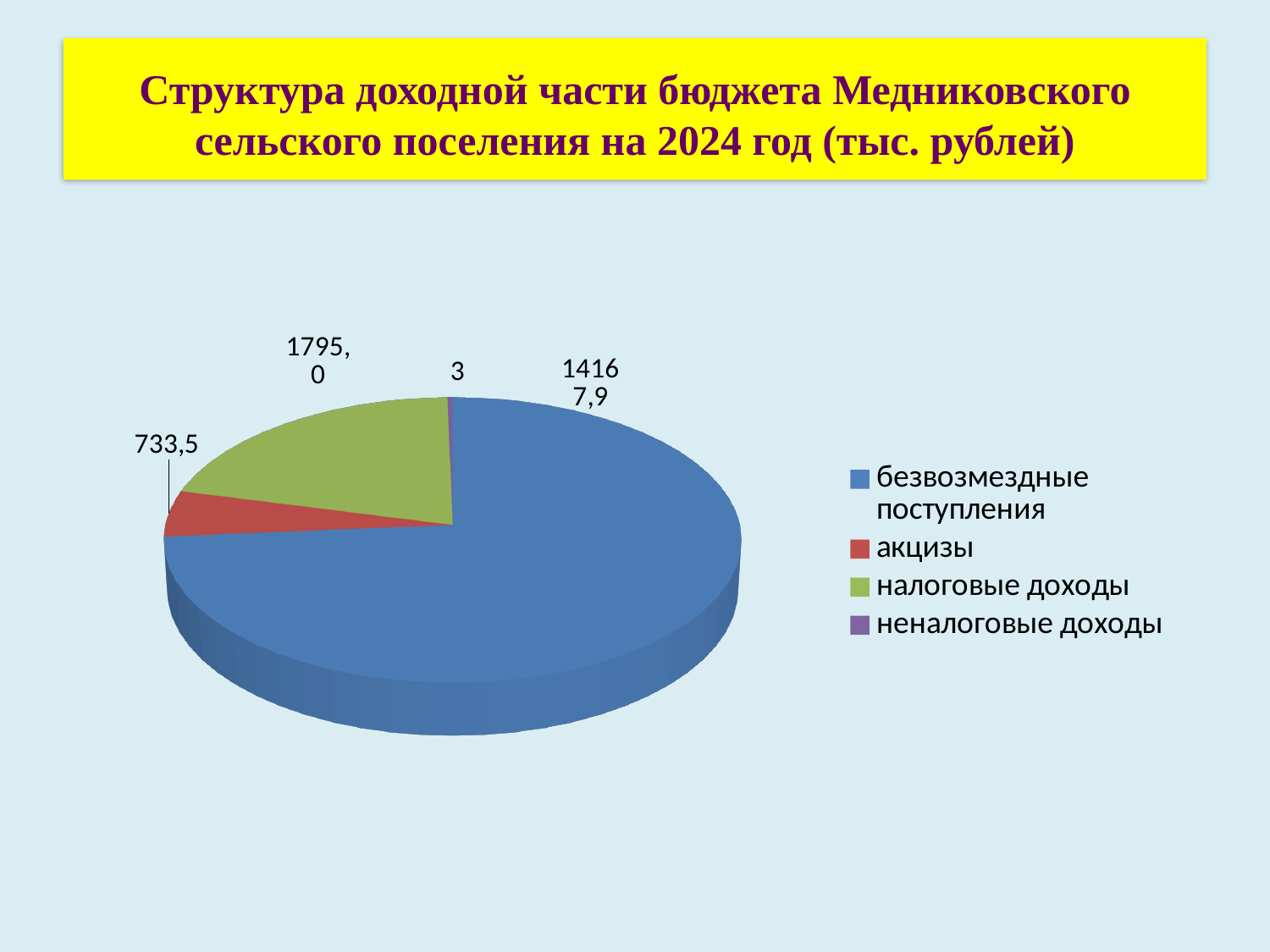
What is the total of all four slices? 16699,4 How many categories does the legend list? 4 Which category has the largest slice of the pie? безвозмездные поступления What is the value for акцизы? 733,5 What kind of chart is shown on the slide? Pie chart What is the value for безвозмездные поступления? 14167,9 What colour is the slice for налоговые доходы? Green What is the value for налоговые доходы? 1795,0 Which category has the smallest slice of the pie? неналоговые доходы Which is larger, налоговые доходы or акцизы? налоговые доходы What is the value for неналоговые доходы? 3 What is the difference between налоговые доходы and акцизы? 1061,5